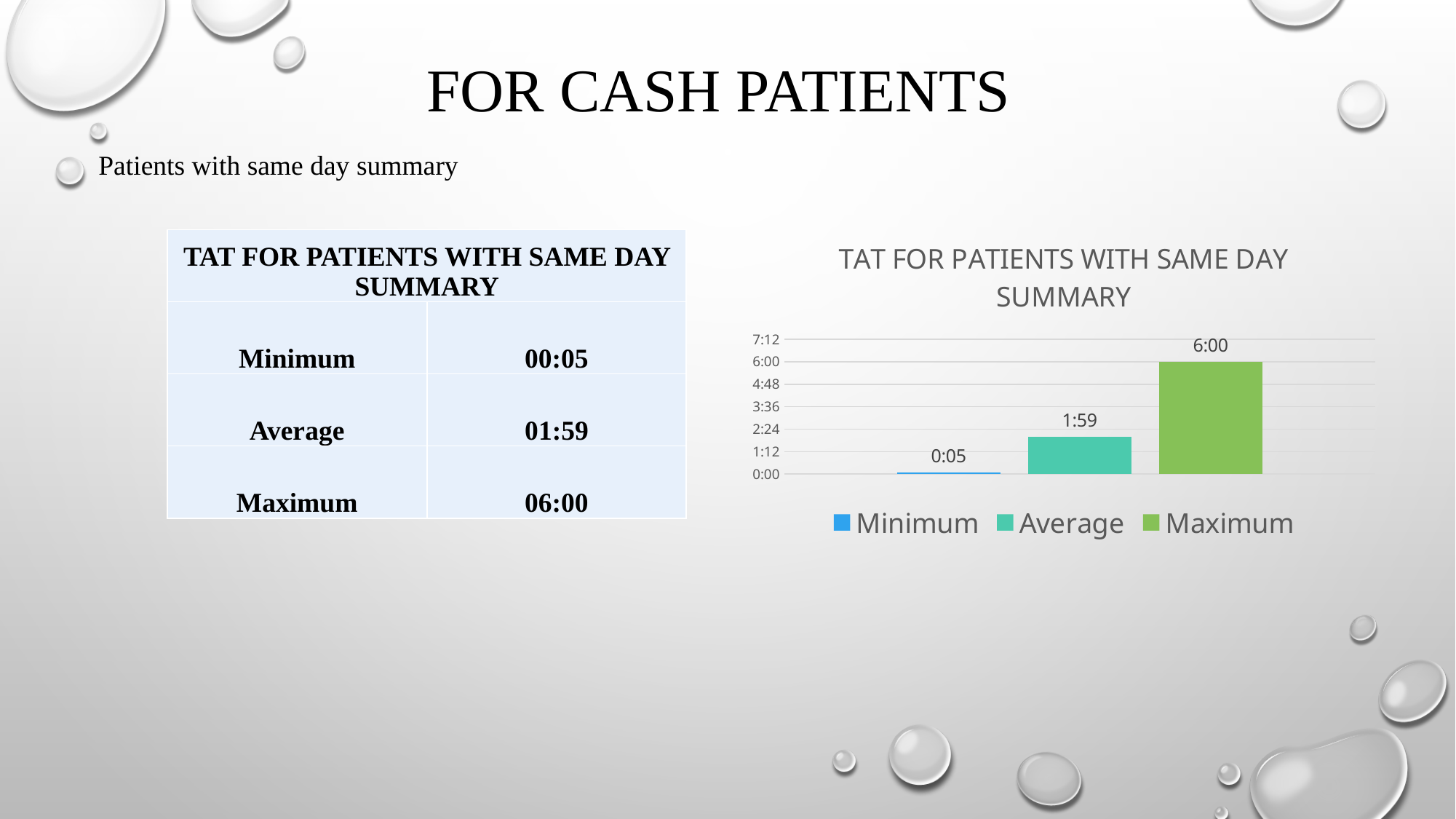
What is the value of the Average bar in the chart? 1:59 How many bars are plotted in the chart? 3 What is the title of the chart? TAT FOR PATIENTS WITH SAME DAY SUMMARY Which is larger in the chart, the Average value or the Minimum value? Average How many series does the chart legend list? 3 What kind of chart is shown on the slide? bar chart Which series has the highest value in the chart? Maximum What is the value of the Maximum bar in the chart? 6:00 Which series has the lowest value in the chart? Minimum Is the value for Average greater or less than 2:24? less What is the value of the Minimum bar in the chart? 0:05 Is the value for Maximum greater or less than 4:48? greater